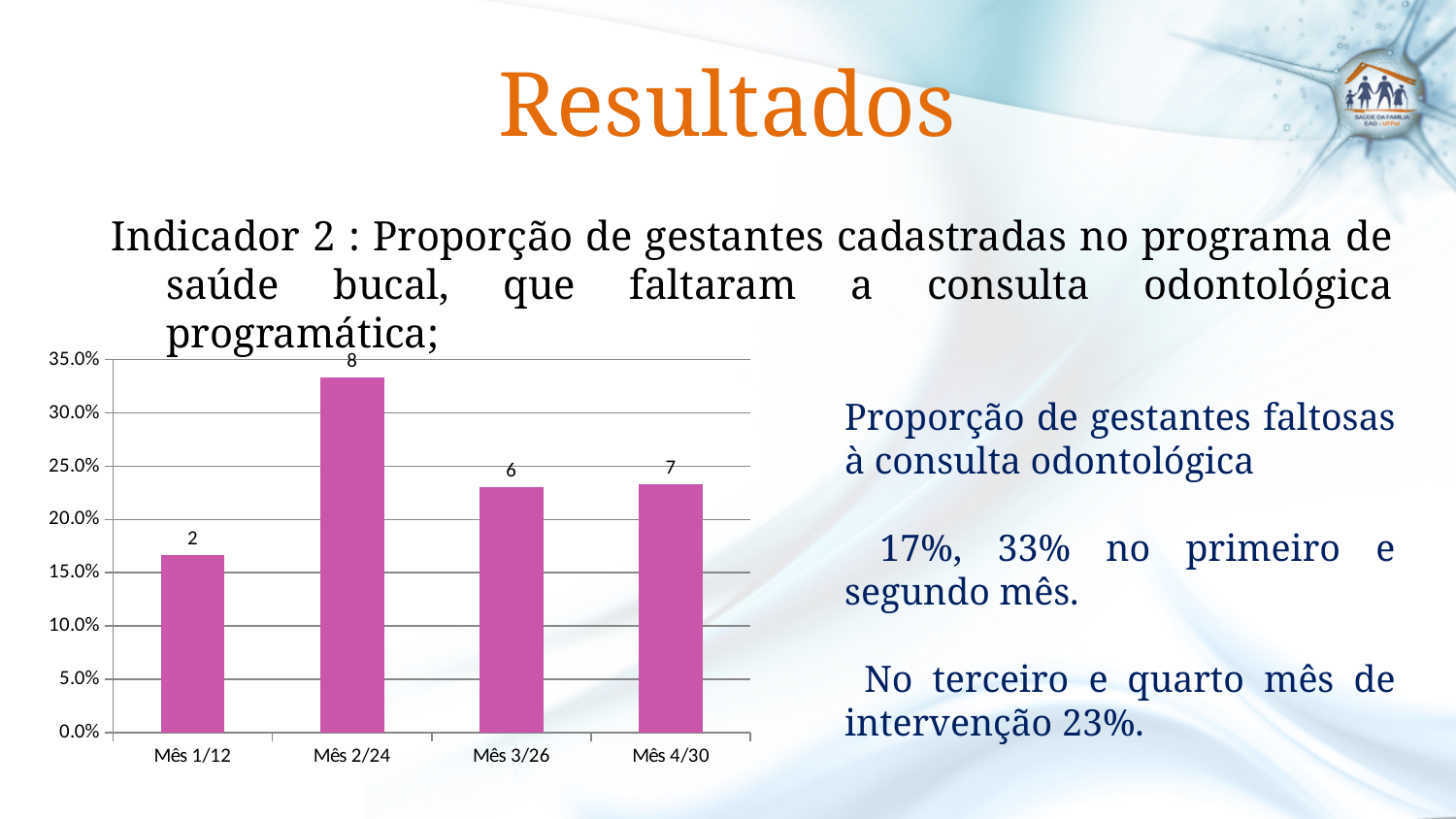
Which month has the highest bar? Mês 2/24 What type of chart is shown on the slide? bar chart What data label is shown on the bar for Mês 4/30? 7 What data label is shown on the bar for Mês 3/26? 6 Which month has the lowest bar? Mês 1/12 What data label is shown on the bar for Mês 2/24? 8 What data label is shown on the bar for Mês 1/12? 2 How many categories (months) are plotted on the chart? 4 Which bar is taller, Mês 1/12 or Mês 3/26? Mês 3/26 Is the value for Mês 1/12 greater or less than 20.0%? less What is the difference between the data labels for Mês 2/24 and Mês 1/12? 6 Is the value for Mês 2/24 greater or less than 30.0%? greater